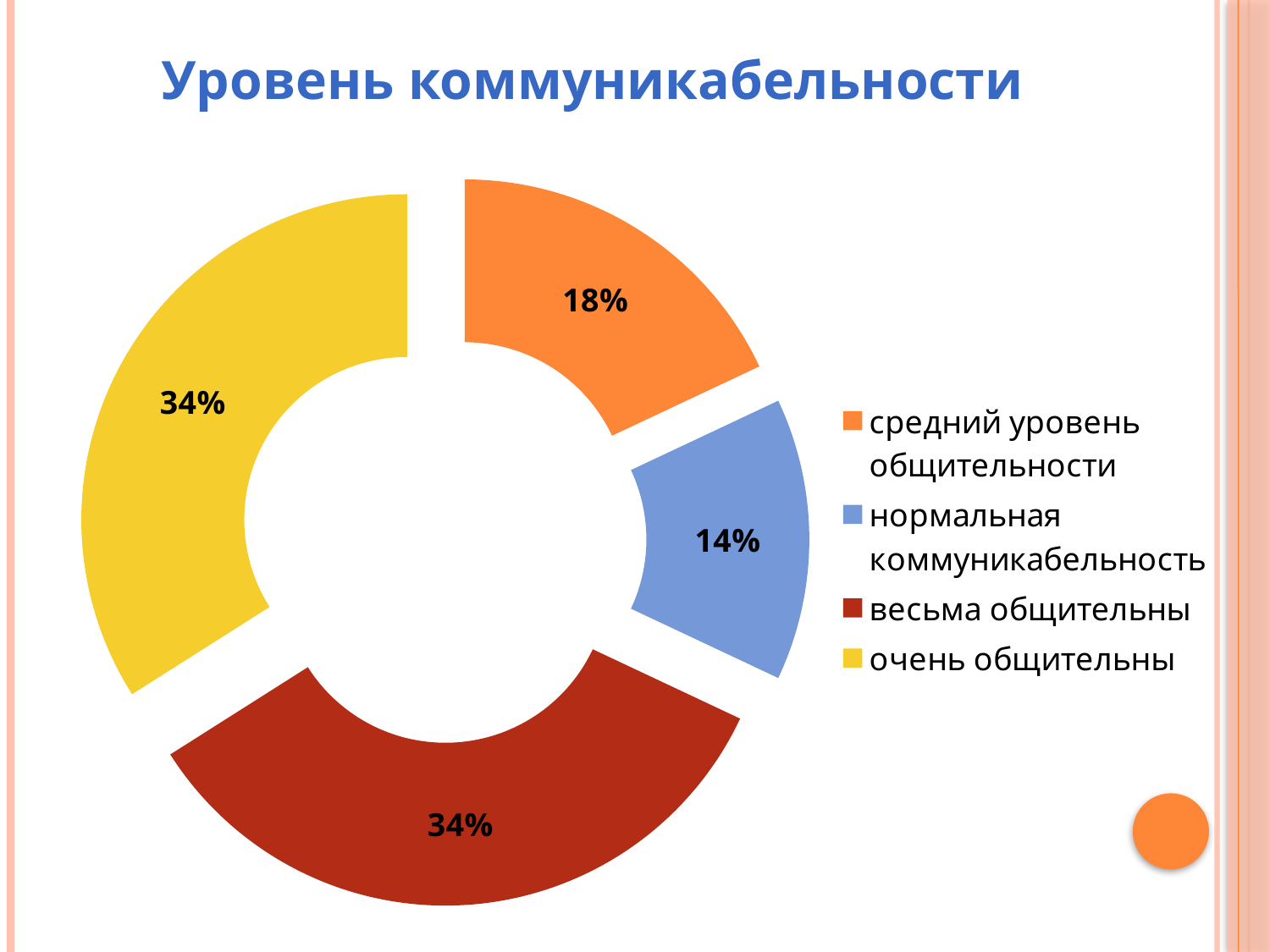
What percentage is shown for 'нормальная коммуникабельность'? 14% Which is larger: the share for 'средний уровень общительности' or for 'нормальная коммуникабельность'? средний уровень общительности What kind of chart is shown on the slide? doughnut chart What percentage is shown for 'средний уровень общительности'? 18% What is the title of the chart? Уровень коммуникабельности What percentage is shown for 'весьма общительны'? 34% Which category has the smallest share of the chart? нормальная коммуникабельность What is the difference in percentage points between 'весьма общительны' and 'средний уровень общительности'? 16 Which is larger: the share for 'очень общительны' or for 'нормальная коммуникабельность'? очень общительны How many categories does the chart show? 4 What percentage is shown for 'очень общительны'? 34% What is the difference in percentage points between 'средний уровень общительности' and 'нормальная коммуникабельность'? 4